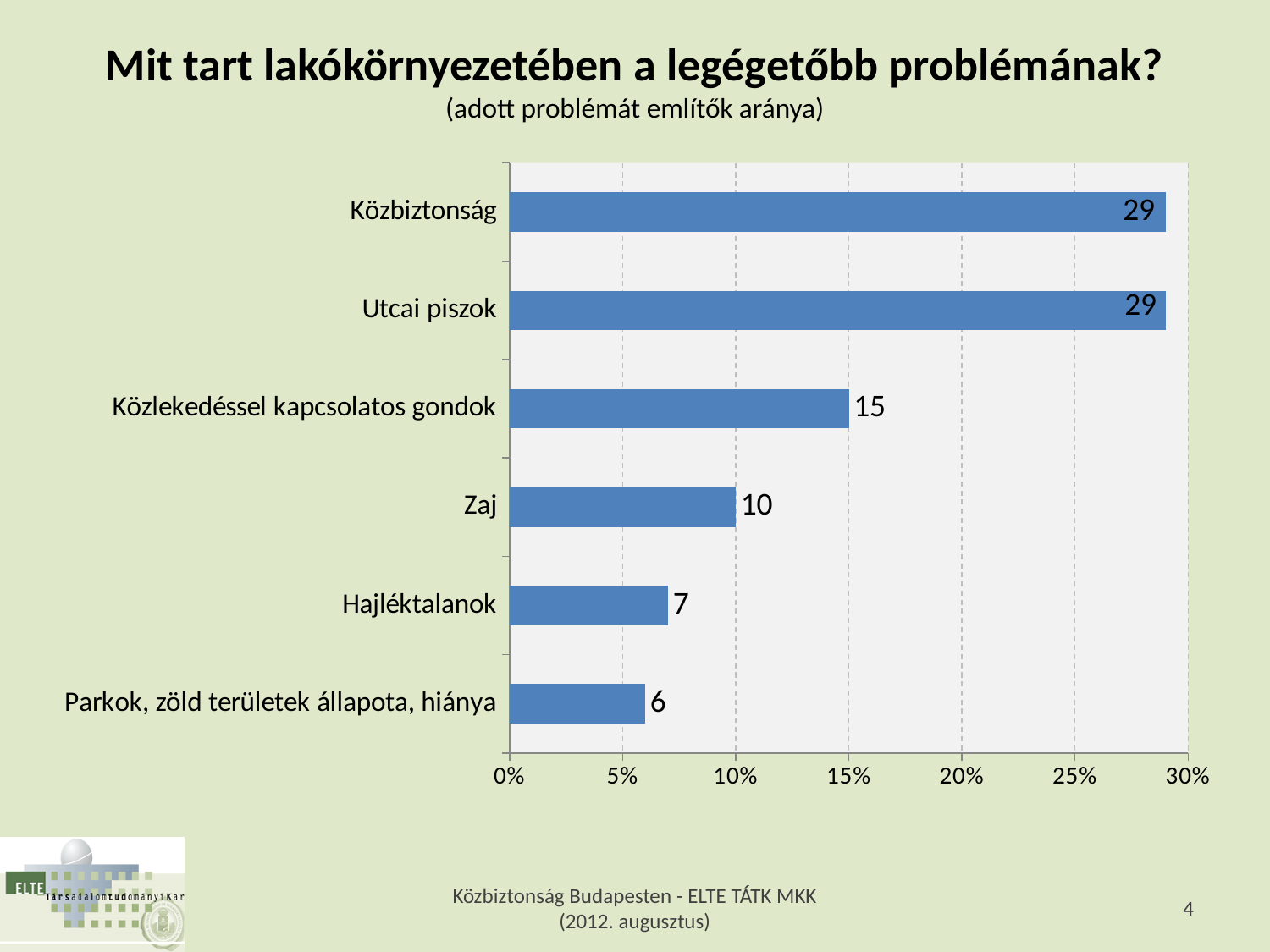
What value is shown for Utcai piszok? 29 How many categories are shown in the chart? 6 Which is larger, the value for Zaj or the value for Hajléktalanok? Zaj What kind of chart is shown on the slide? bar chart What is the difference between the values for Közbiztonság and Zaj? 19 What value is shown for Zaj? 10 Which category has the lowest value? Parkok, zöld területek állapota, hiánya What is the difference between the values for Közlekedéssel kapcsolatos gondok and Hajléktalanok? 8 Is the value for Közbiztonság greater or less than 25%? greater What value is shown for Hajléktalanok? 7 What value is shown for Közlekedéssel kapcsolatos gondok? 15 What is the title of the chart on the slide? Mit tart lakókörnyezetében a legégetőbb problémának?